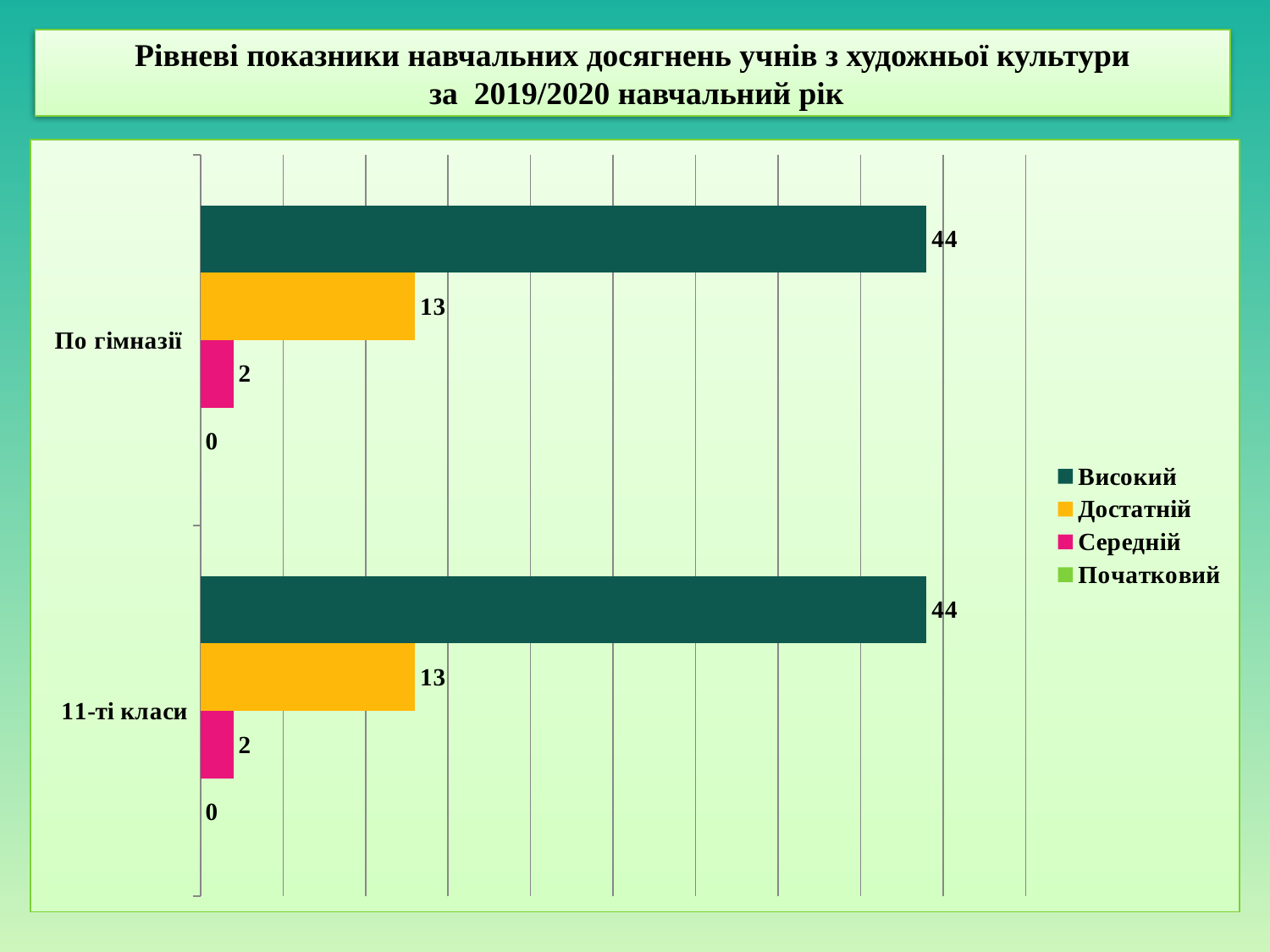
What is the difference between the Високий and Достатній values in the По гімназії category? 31 What is the value for Достатній in the 11-ті класи category? 13 What colour are the Високий bars? dark green What type of chart is shown on the slide? bar chart What is the value for Високий in the По гімназії category? 44 How many series does the legend list? 4 Which series has the lowest value in the По гімназії category? Початковий Which series has the highest value in the 11-ті класи category? Високий How many categories are shown on the y axis? 2 What is the value for Середній in the По гімназії category? 2 What is the value for Початковий in the 11-ті класи category? 0 Which is larger in the 11-ті класи category: Достатній or Середній? Достатній